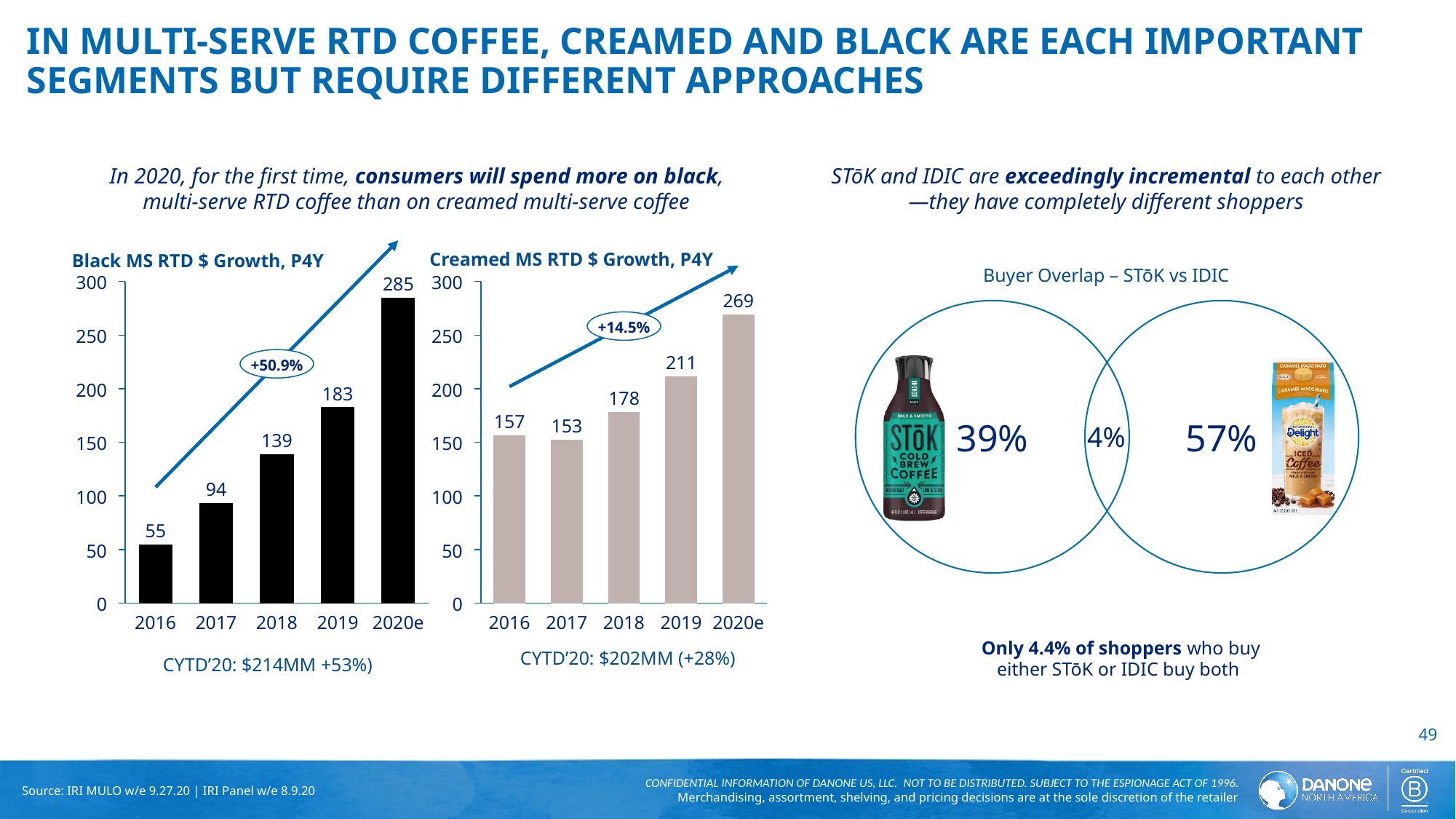
In the 'Creamed MS RTD $ Growth, P4Y' chart, what is the difference between the 2018 value and the 2016 value? 21 In the 'Black MS RTD $ Growth, P4Y' chart, which year has the lowest value? 2016 Which is larger: the 2017 value in the 'Black MS RTD $ Growth, P4Y' chart or the 2017 value in the 'Creamed MS RTD $ Growth, P4Y' chart? Creamed MS RTD $ Growth, P4Y In the 'Black MS RTD $ Growth, P4Y' chart, what is the difference between the 2020e value and the 2019 value? 102 In the 'Creamed MS RTD $ Growth, P4Y' chart, what is the value for 2019? 211 What growth percentage is shown in the oval callout on the 'Black MS RTD $ Growth, P4Y' chart? +50.9% What kind of chart is 'Creamed MS RTD $ Growth, P4Y'? Bar chart In the 'Creamed MS RTD $ Growth, P4Y' chart, which year has the lowest value? 2017 In the 'Black MS RTD $ Growth, P4Y' chart, what is the value for 2018? 139 How many years are shown on the x axis of the 'Black MS RTD $ Growth, P4Y' chart? 5 In the 'Black MS RTD $ Growth, P4Y' chart, do the values rise or fall from 2016 to 2020e? Rise In the 'Creamed MS RTD $ Growth, P4Y' chart, which year has the highest value? 2020e